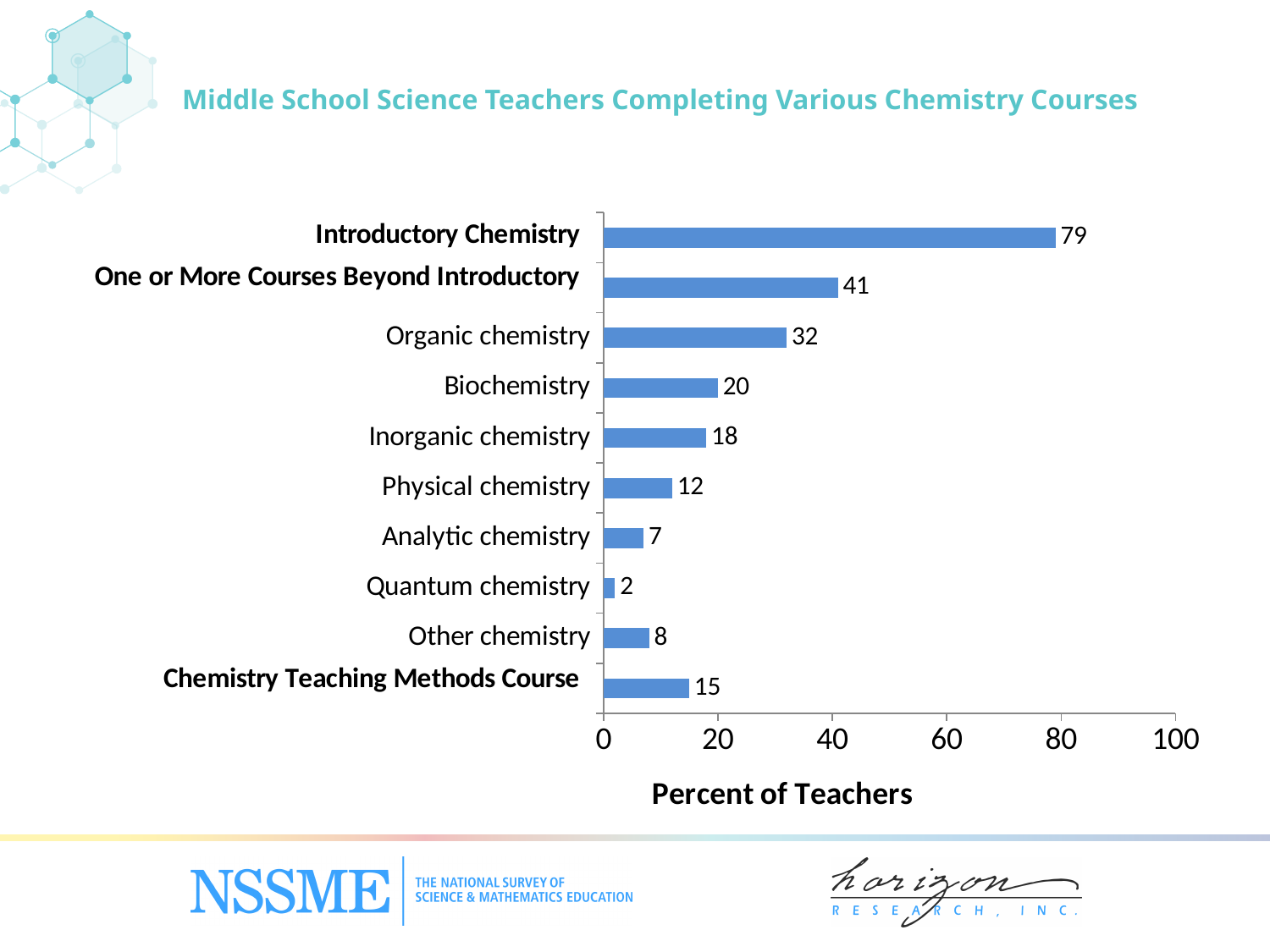
Is the value for Physical chemistry greater or less than 20? less What is the title of the chart? Middle School Science Teachers Completing Various Chemistry Courses What is the value for Organic chemistry? 32 What is the difference between the values for Introductory Chemistry and One or More Courses Beyond Introductory? 38 Which category has the lowest value? Quantum chemistry What percent of middle school science teachers completed Introductory Chemistry? 79 What percent of teachers completed a Chemistry Teaching Methods Course? 15 Which category has the highest value? Introductory Chemistry Which is larger, the value for Biochemistry or the value for Inorganic chemistry? Biochemistry How many categories are shown in the chart? 10 What kind of chart is shown on the slide? Bar chart What is the label of the horizontal axis? Percent of Teachers